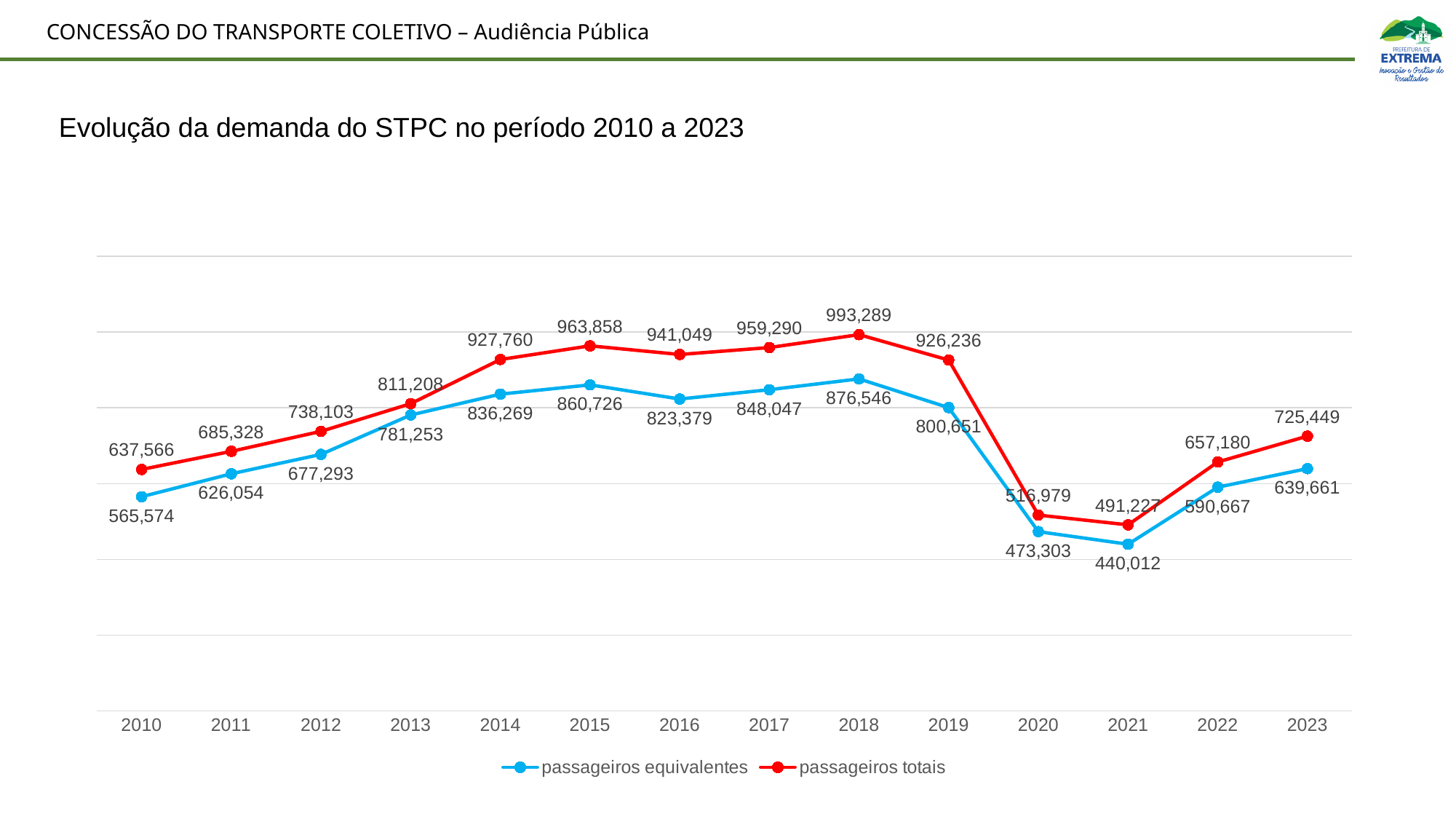
What is the difference between passageiros totais and passageiros equivalentes in 2018? 116,743 What is the value of passageiros equivalentes in 2021? 440,012 Do the values of passageiros totais rise or fall from 2018 to 2021? fall What is the value of passageiros totais in 2018? 993,289 What is the difference between passageiros totais and passageiros equivalentes in 2023? 85,788 How many series does the legend list? 2 How many years are shown on the x axis? 14 In which year is passageiros totais highest? 2018 Which is larger: passageiros equivalentes in 2015 or in 2016? 2015 What is the value of passageiros totais in 2023? 725,449 In which year is passageiros equivalentes lowest? 2021 What kind of chart is shown on the slide? line chart